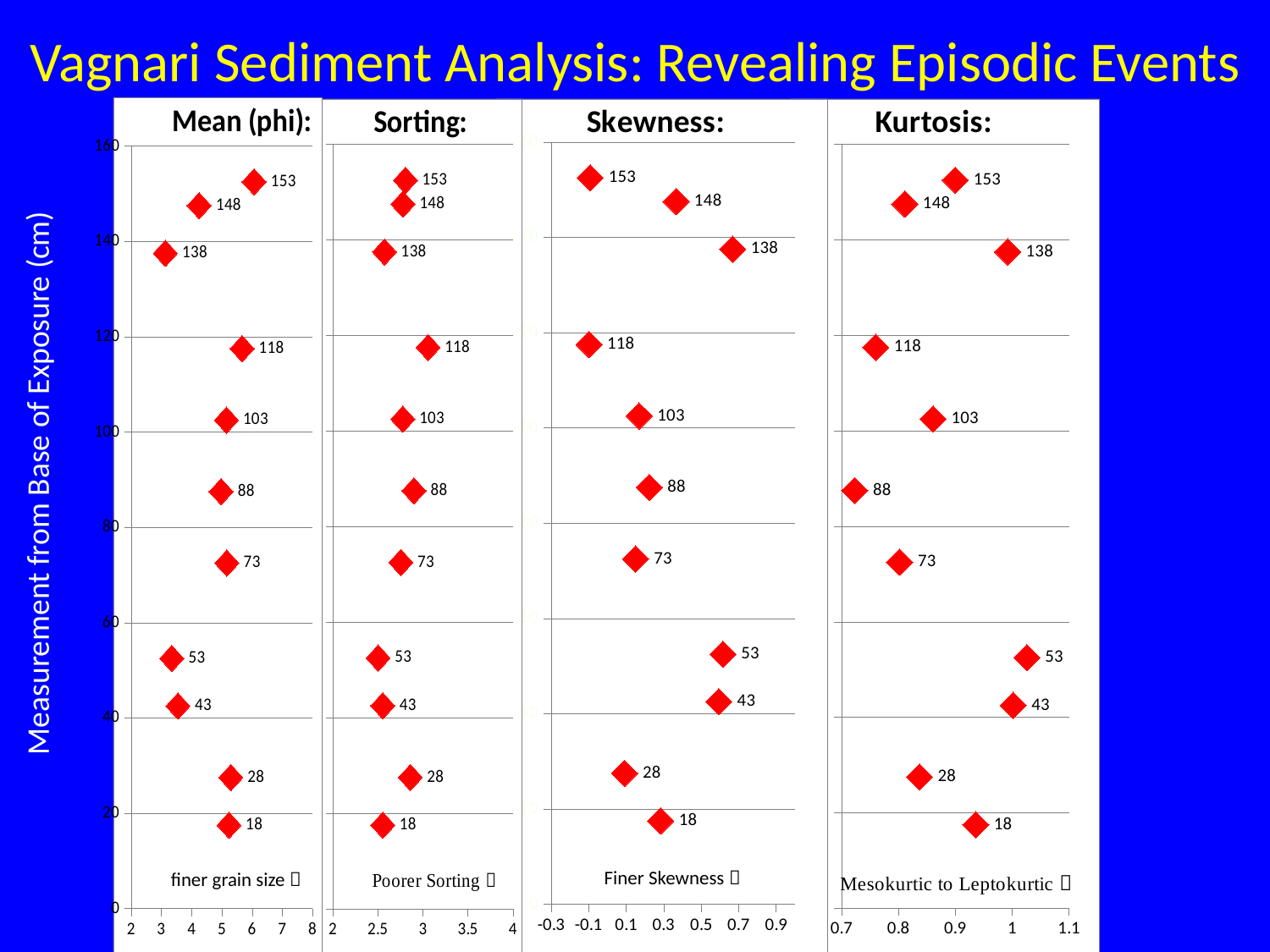
How many data points are plotted in the Kurtosis chart? 11 In the Kurtosis chart, is the value for the point labelled 53 greater or less than 0.9? greater In the Kurtosis chart, which labelled point has the lowest kurtosis value (furthest left)? 88 In the Skewness chart, is the value for the point labelled 153 greater or less than 0.1? less In the Sorting chart, is the value for the point labelled 53 greater or less than 3? less What is the label on the shared vertical axis of the charts? Measurement from Base of Exposure (cm) In the Skewness chart, which has the larger skewness value: the point labelled 138 or the point labelled 118? 138 What kind of chart is the Mean (phi) chart? scatter chart In the Mean (phi) chart, which labelled point has the highest mean value (furthest right)? 153